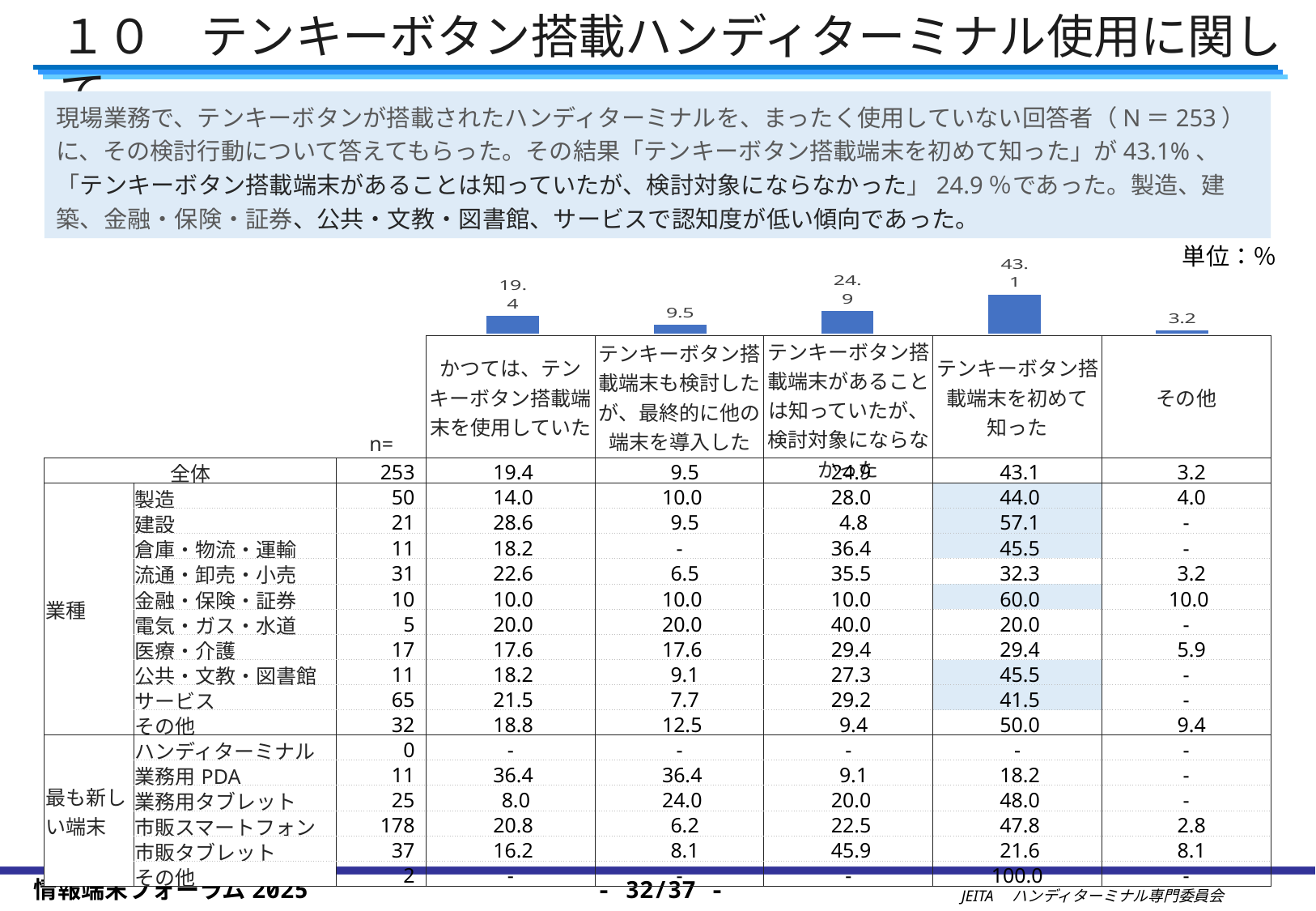
What is the value of the bar for 「その他」? 3.2 What unit is indicated for the values in the chart? % What is the value of the bar for 「かつては、テンキーボタン搭載端末を使用していた」? 19.4 What type of chart is shown above the table on the slide? bar chart How many bars are plotted in the chart above the table? 5 What is the difference between the bar for 「かつては、テンキーボタン搭載端末を使用していた」 and the bar for 「テンキーボタン搭載端末も検討したが、最終的に他の端末を導入した」? 9.9 What is the difference between the bar for 「テンキーボタン搭載端末を初めて知った」 and the bar for 「テンキーボタン搭載端末があることは知っていたが、検討対象にならなかった」? 18.2 Which category has the lowest bar in the chart? その他 What is the value of the bar for 「テンキーボタン搭載端末があることは知っていたが、検討対象にならなかった」? 24.9 Which category has the highest bar in the chart? テンキーボタン搭載端末を初めて知った What is the value of the bar for 「テンキーボタン搭載端末を初めて知った」? 43.1 Which is larger: the bar for 「かつては、テンキーボタン搭載端末を使用していた」 or the bar for 「テンキーボタン搭載端末も検討したが、最終的に他の端末を導入した」? かつては、テンキーボタン搭載端末を使用していた